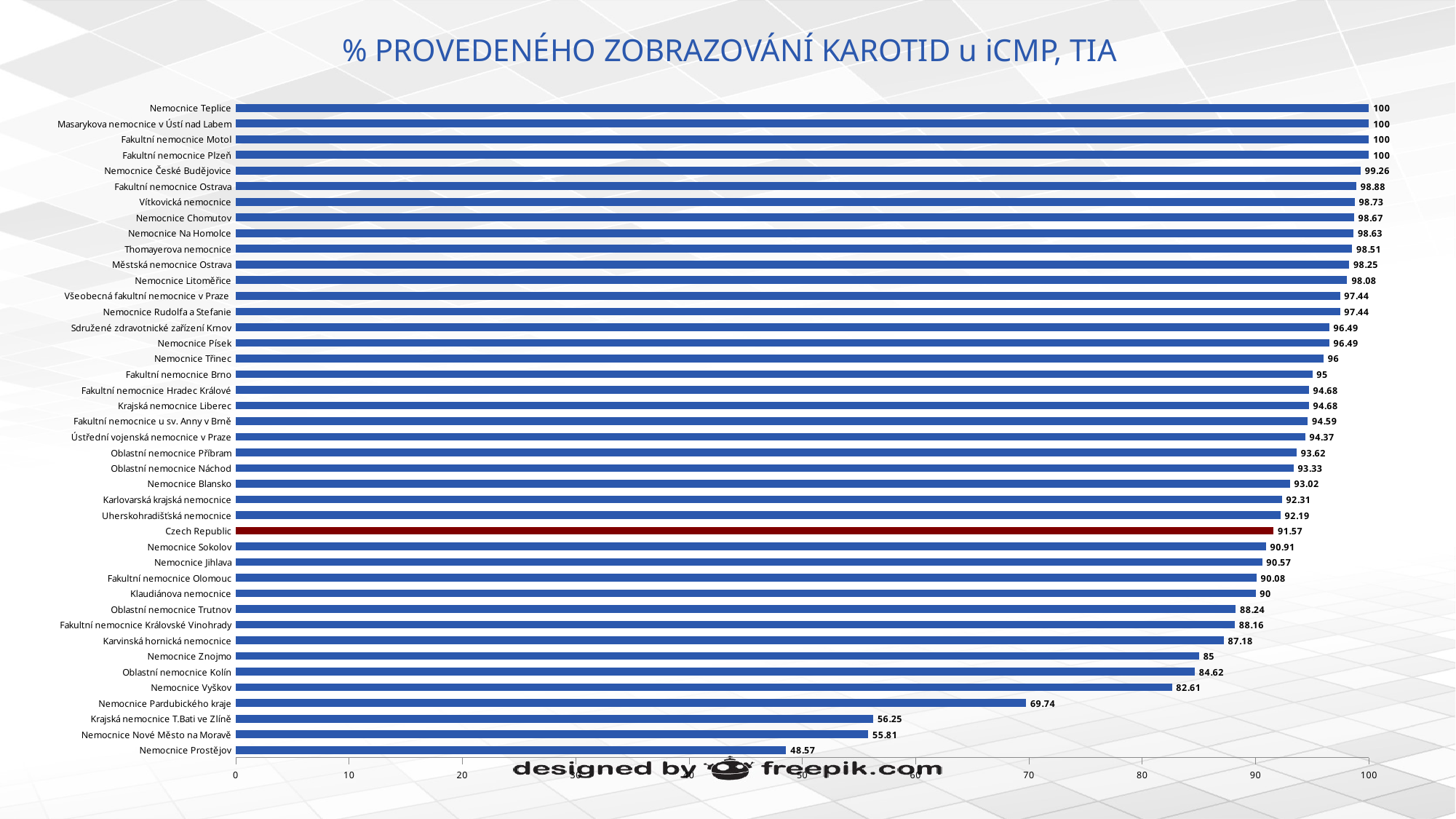
What is the difference between the values for Nemocnice Teplice and Nemocnice Vyškov? 17.39 What is the value for Nemocnice Pardubického kraje? 69.74 What is the value for Czech Republic? 91.57 What is the title of the chart? % PROVEDENÉHO ZOBRAZOVÁNÍ KAROTID u iCMP, TIA Is the value for Krajská nemocnice T.Bati ve Zlíně greater or less than 60? less What is the value for Nemocnice Prostějov? 48.57 What type of chart is shown on the slide? bar chart How many categories are plotted in the chart? 42 What is the difference between the values for Czech Republic and Nemocnice Prostějov? 43 Which category has the lowest value? Nemocnice Prostějov Which has a larger value, Nemocnice Znojmo or Oblastní nemocnice Kolín? Nemocnice Znojmo What is the value for Fakultní nemocnice Brno? 95